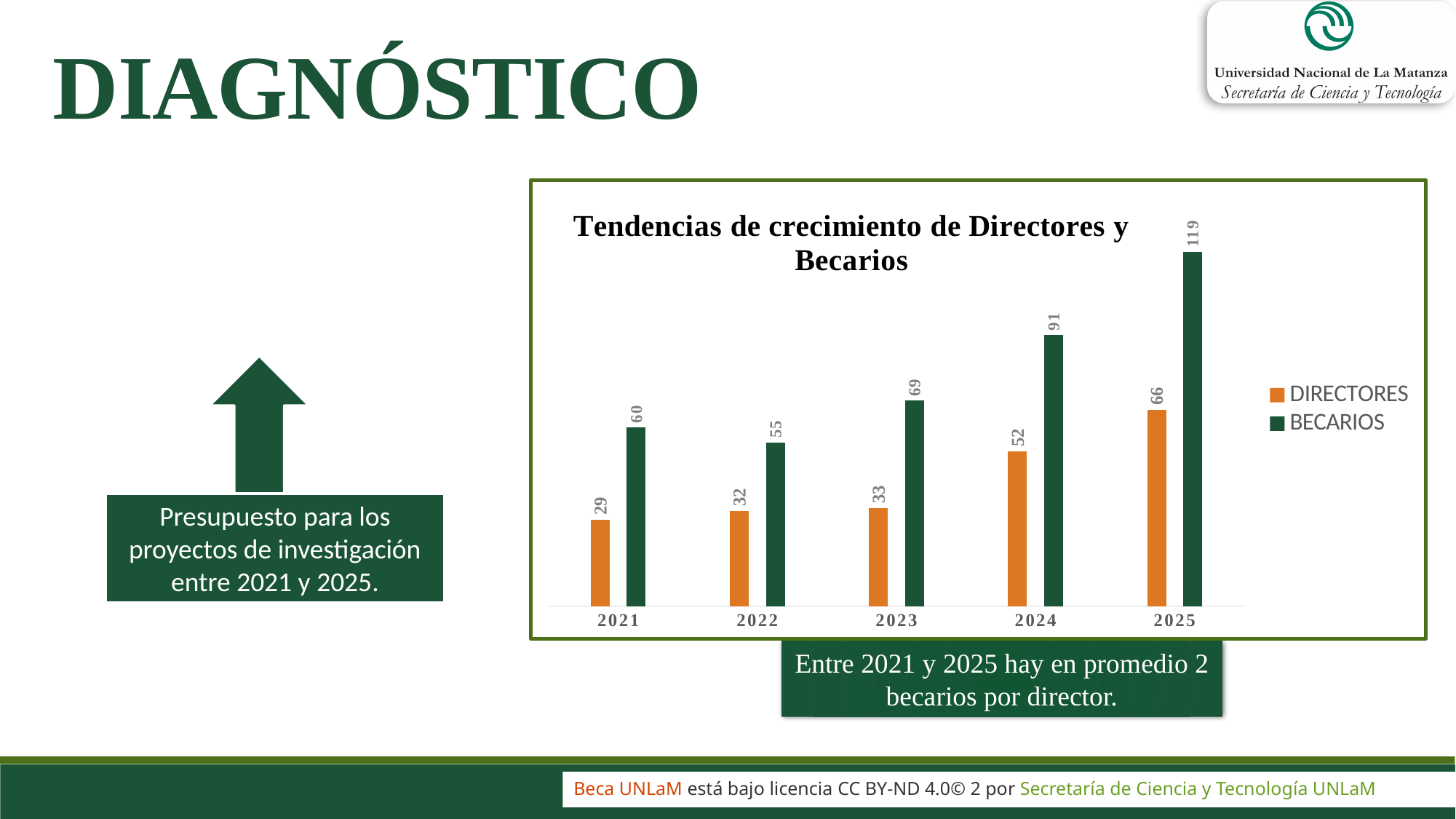
Do the DIRECTORES values rise or fall from 2021 to 2025? rise What is the difference between BECARIOS and DIRECTORES in 2024? 39 Which year has the lowest value for DIRECTORES? 2021 Which is larger, BECARIOS in 2021 or BECARIOS in 2022? BECARIOS in 2021 What is the title of the chart? Tendencias de crecimiento de Directores y Becarios How many years are shown on the x axis? 5 What is the value for BECARIOS in 2025? 119 Which year has the highest value for BECARIOS? 2025 What is the value for BECARIOS in 2022? 55 How many series does the legend list? 2 What is the value for DIRECTORES in 2021? 29 What kind of chart is shown? bar chart